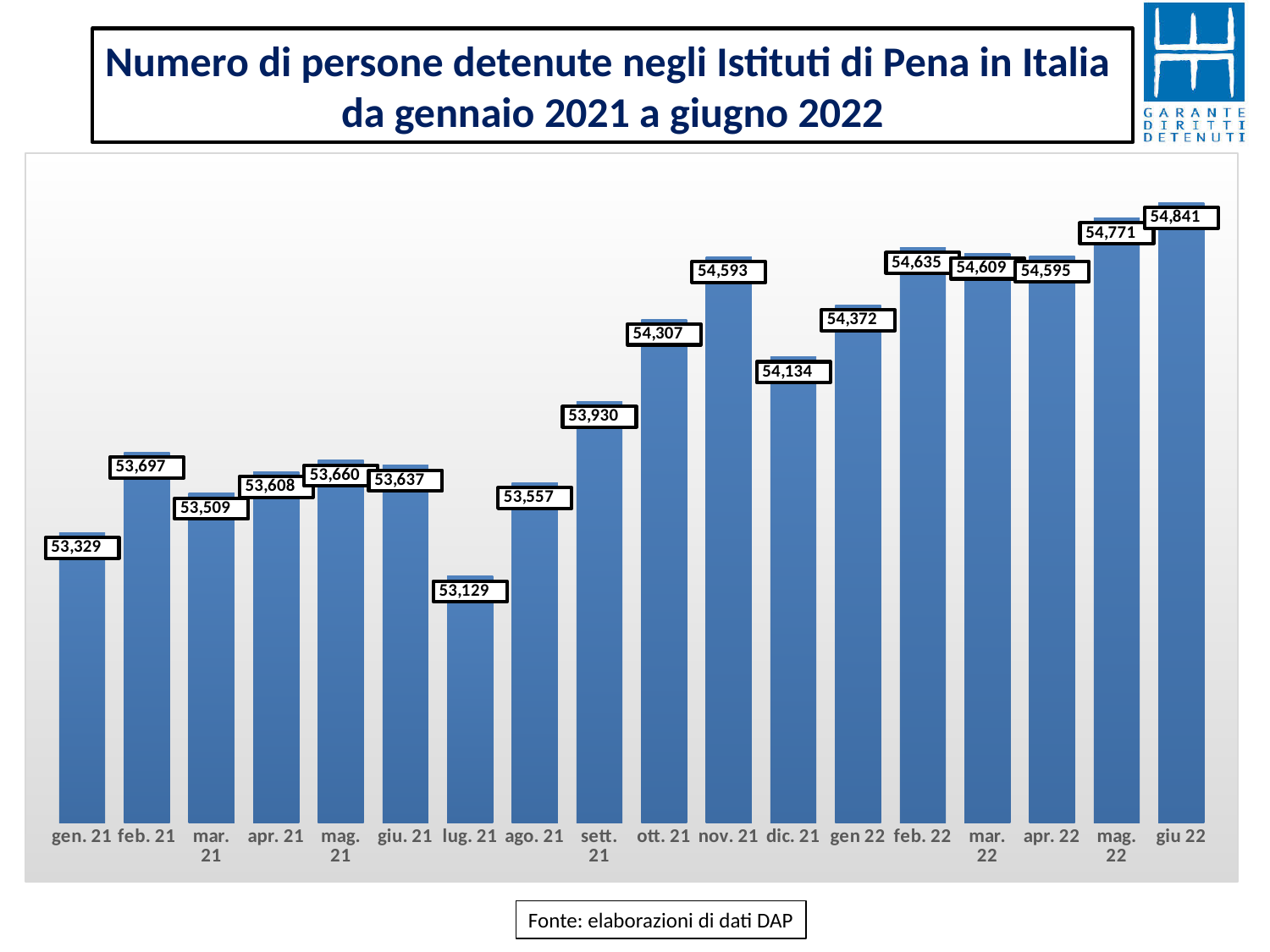
What is the difference between the values for nov. 21 and dic. 21? 459 What is the difference between the values for giu 22 and gen. 21? 1,512 What is the value for gen. 21? 53,329 What is the title of the chart? Numero di persone detenute negli Istituti di Pena in Italia da gennaio 2021 a giugno 2022 Do the values generally rise or fall from gen. 21 to giu 22? rise Which month has the highest value? giu 22 Which is larger, the value for ott. 21 or the value for gen 22? gen 22 What kind of chart is this? bar chart Which month has the lowest value? lug. 21 What is the value for lug. 21? 53,129 What is the value for nov. 21? 54,593 How many months are shown on the x axis? 18